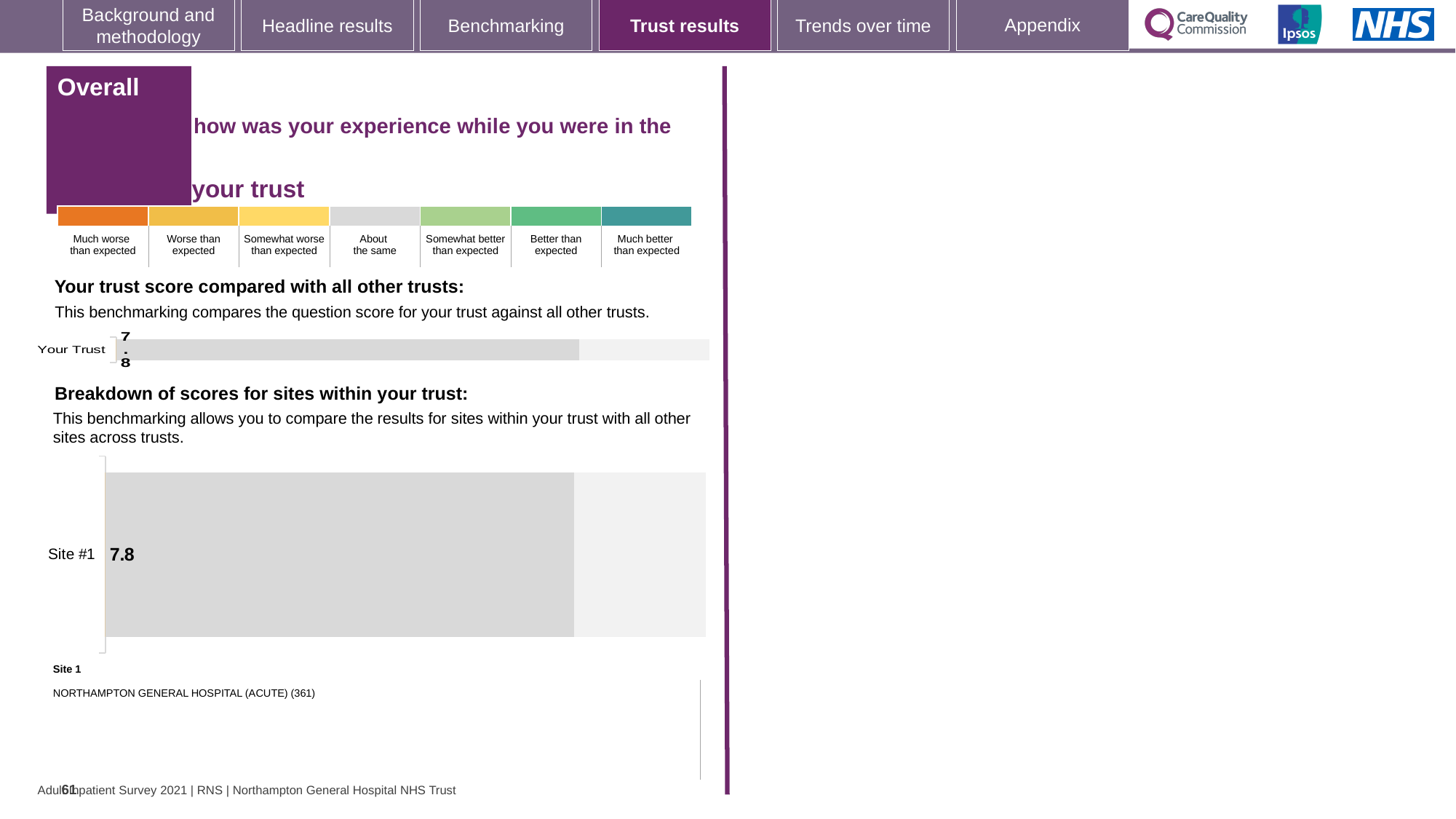
In the 'Breakdown of scores for sites within your trust' chart, what is the value for Site #1? 7.8 How many categories are plotted in the 'Breakdown of scores for sites within your trust' chart? 1 What kind of chart is the 'Breakdown of scores for sites within your trust' chart? bar chart What kind of chart is the 'Your trust score compared with all other trusts' chart? bar chart In the 'Your trust score compared with all other trusts' chart, what is the value for Your Trust? 7.8 What is the difference between the Your Trust value in the upper chart and the Site #1 value in the lower chart? 0 How many categories are plotted in the 'Your trust score compared with all other trusts' chart? 1 In the 'Breakdown of scores for sites within your trust' chart, what is the label of the only category? Site #1 According to the slide, which hospital is Site 1? NORTHAMPTON GENERAL HOSPITAL (ACUTE) (361)